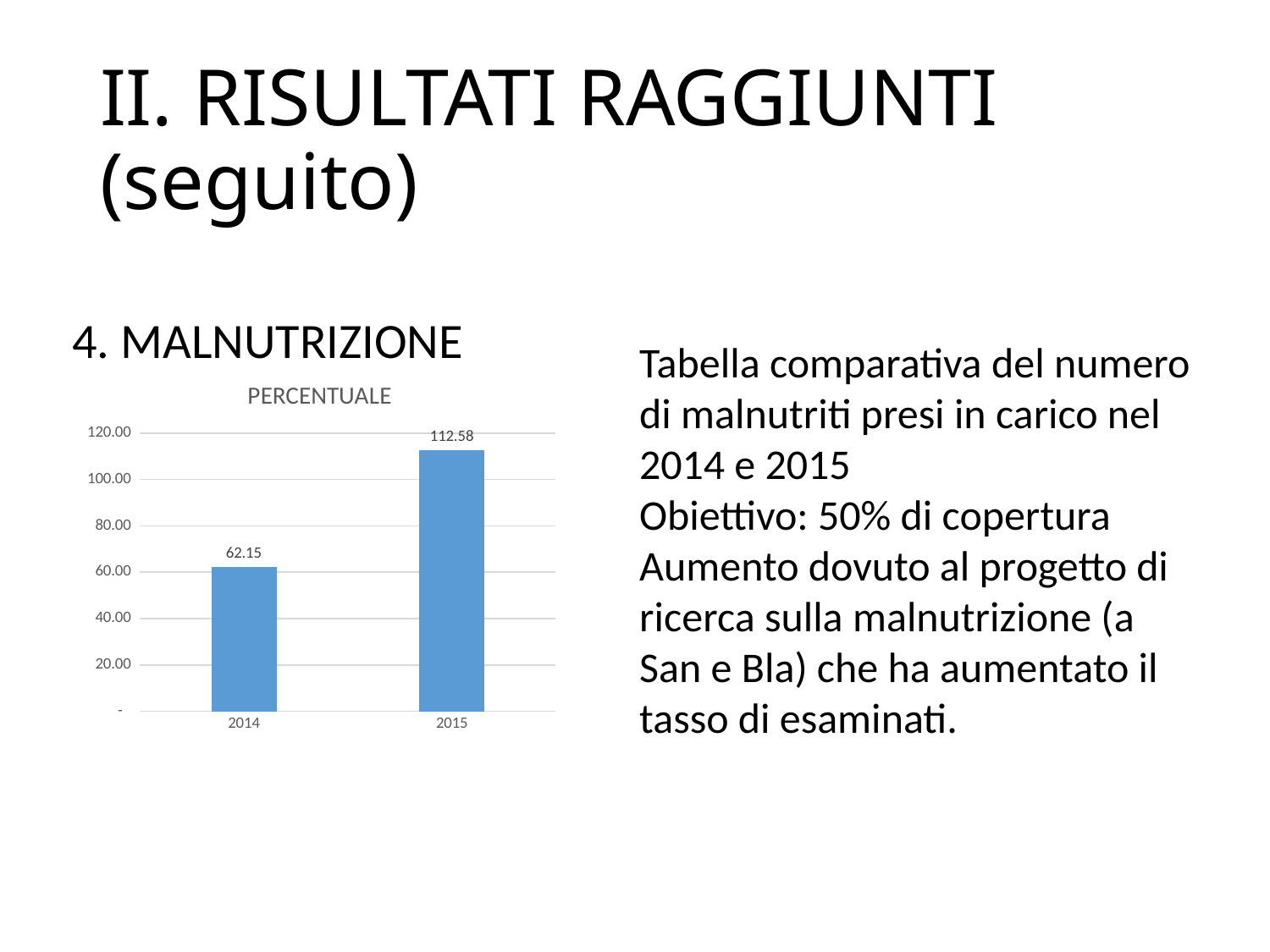
How many categories are shown on the x axis? 2 What is the difference between the values for 2015 and 2014? 50.43 Is the value for 2014 greater or less than 80.00? less Which year has the lowest value? 2014 What is the title of the chart? PERCENTUALE Which is larger, the value for 2014 or the value for 2015? 2015 What kind of chart is shown? bar chart Which year has the highest value? 2015 What is the value for 2014? 62.15 What is the value for 2015? 112.58 Is the value for 2015 greater or less than 100.00? greater Do the values rise or fall from 2014 to 2015? rise